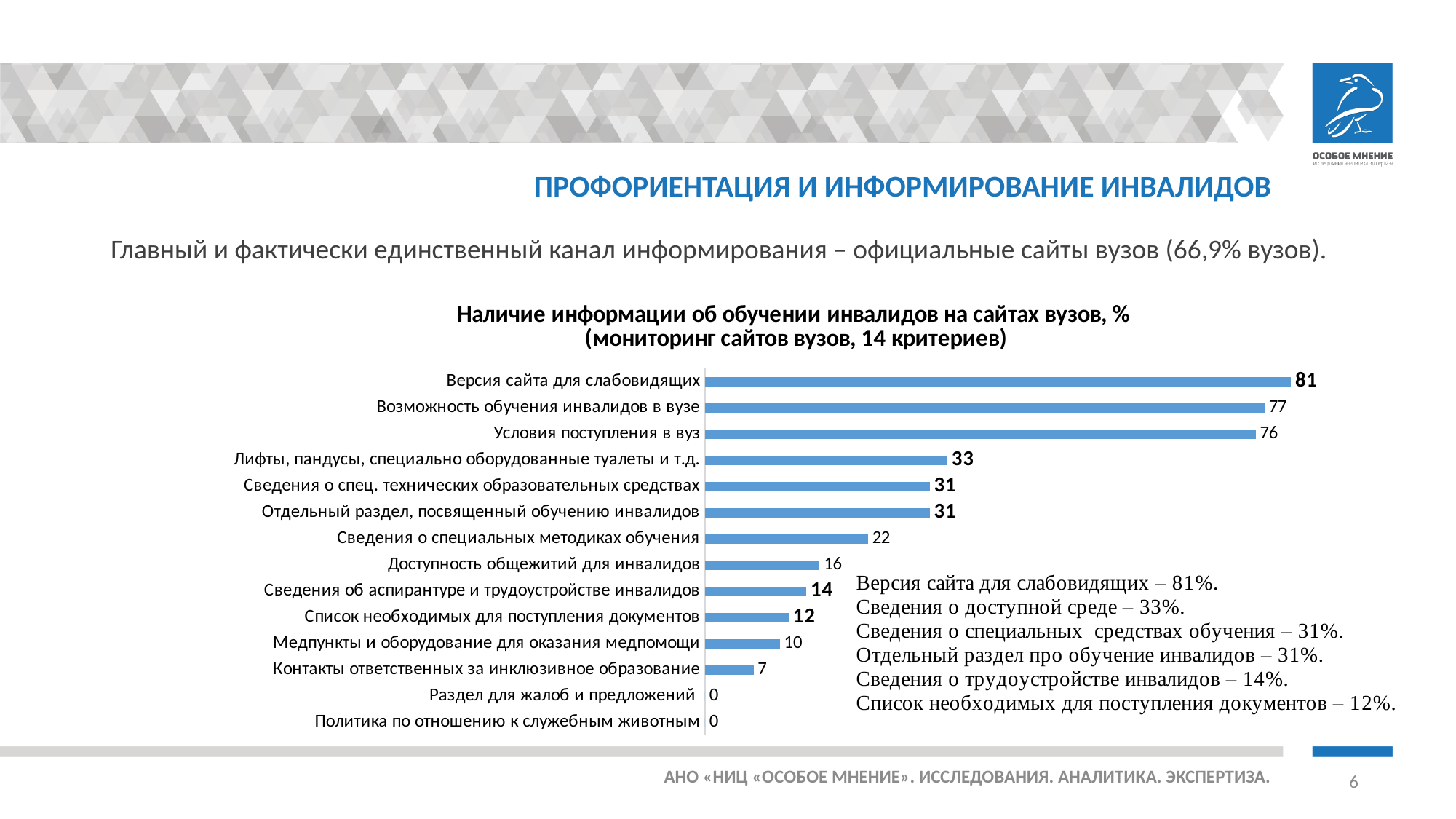
What kind of chart is shown on the slide? Bar chart How many categories are plotted in the chart? 14 Which is larger: the value for «Сведения об аспирантуре и трудоустройстве инвалидов» or for «Список необходимых для поступления документов»? Сведения об аспирантуре и трудоустройстве инвалидов What is the title of the chart? Наличие информации об обучении инвалидов на сайтах вузов, % (мониторинг сайтов вузов, 14 критериев) How many categories have a value of 0? 2 What is the difference between the values for «Возможность обучения инвалидов в вузе» and «Условия поступления в вуз»? 1 What value is shown for «Версия сайта для слабовидящих»? 81 What value is shown for «Контакты ответственных за инклюзивное образование»? 7 What value is shown for «Медпункты и оборудование для оказания медпомощи»? 10 What is the difference between the values for «Лифты, пандусы, специально оборудованные туалеты и т.д.» and «Доступность общежитий для инвалидов»? 17 Which category has the highest value in the chart? Версия сайта для слабовидящих What value is shown for «Сведения о специальных методиках обучения»? 22